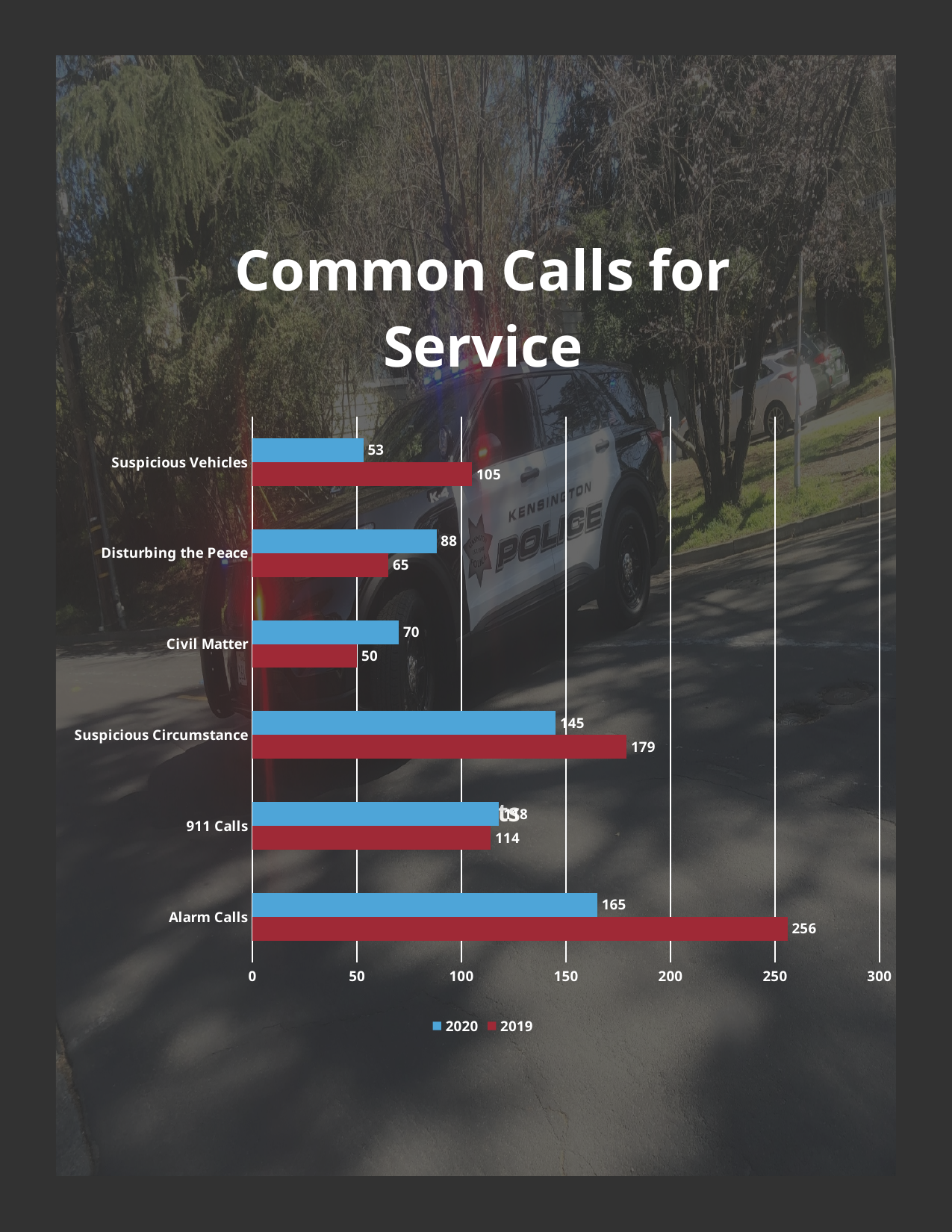
What type of chart is shown on the slide? bar chart What is the 2019 value for Alarm Calls? 256 What is the 2020 value for Suspicious Vehicles? 53 What is the 2019 value for Suspicious Circumstance? 179 For Disturbing the Peace, which year has the larger value, 2020 or 2019? 2020 Which category has the highest 2019 value? Alarm Calls Which category has the lowest 2020 value? Suspicious Vehicles Is the 2020 value for 911 Calls greater or less than 100? greater How many call categories are shown on the chart? 6 How many series does the legend list? 2 What is the difference between the 2019 and 2020 values for Alarm Calls? 91 What is the title of the chart? Common Calls for Service